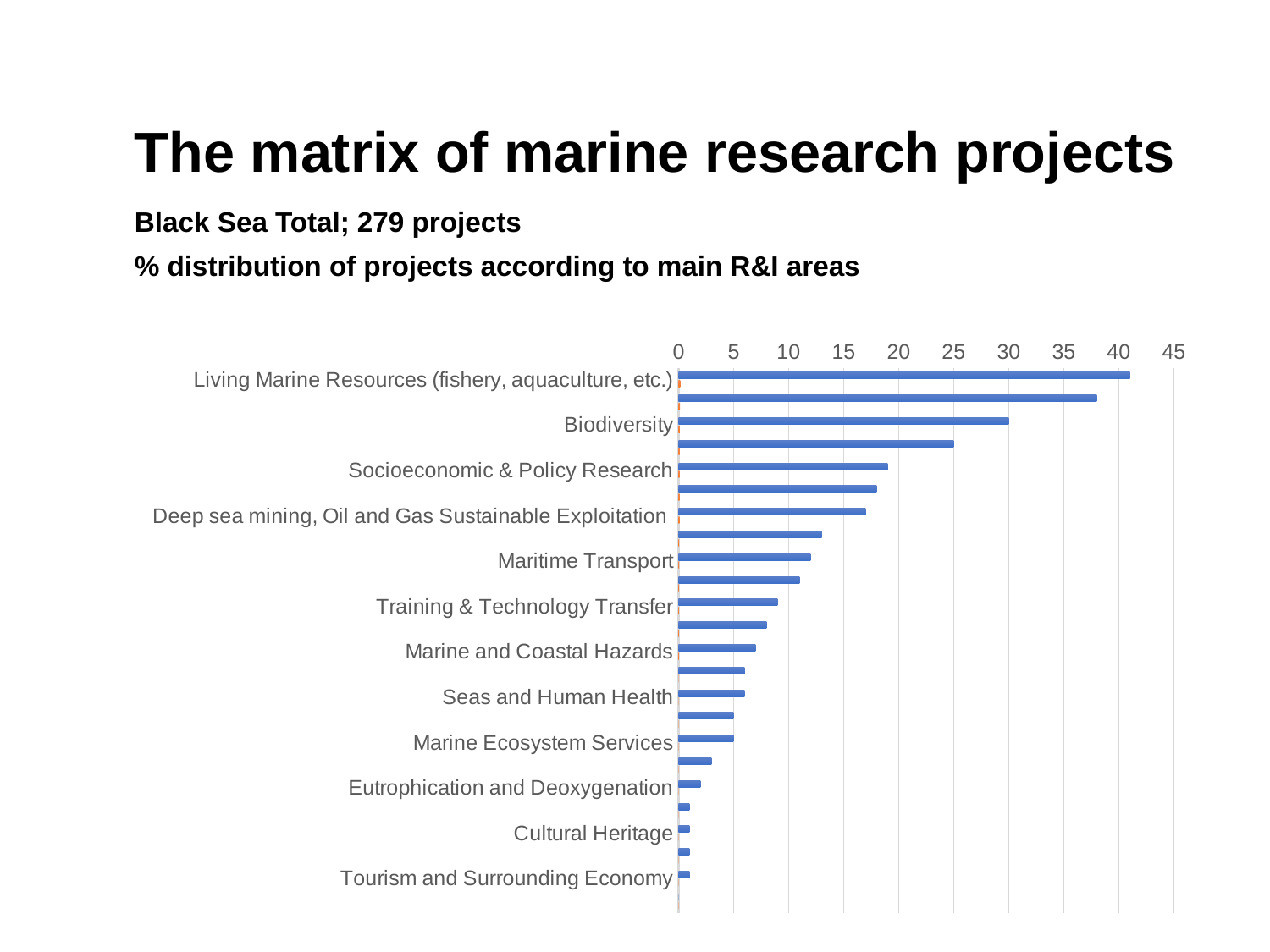
Is the value for Biodiversity greater or less than 25? greater Is the value for Training & Technology Transfer greater or less than 10? less Is the value for Maritime Transport greater or less than 10? greater Do the bar values increase or decrease going from the top of the chart to the bottom? decrease Which category has the highest value? Living Marine Resources (fishery, aquaculture, etc.) What kind of chart is shown on the slide? bar chart Which has a larger value, Biodiversity or Maritime Transport? Biodiversity What is the highest value shown on the horizontal axis? 45